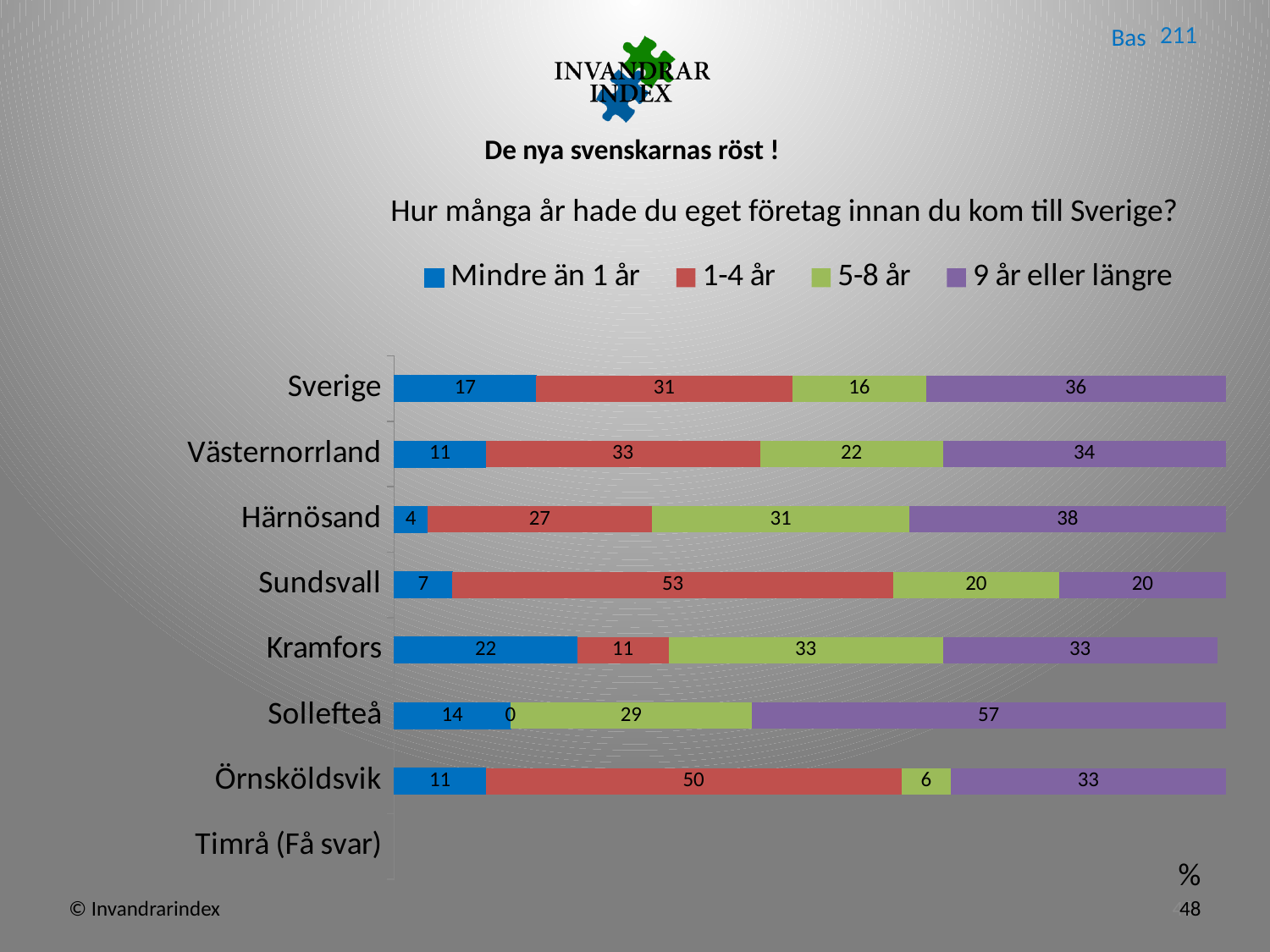
What is the value for '5-8 år' for Örnsköldsvik? 6 What is the value for '9 år eller längre' for Sollefteå? 57 Which category has the highest value for '9 år eller längre'? Sollefteå What kind of chart is shown on the slide? stacked bar chart What is the total of the stacked bar for Sverige? 100 Which category has the lowest value for 'Mindre än 1 år' among those with plotted data? Härnösand What is the difference between the '1-4 år' values for Sundsvall and Kramfors? 42 What is the value for 'Mindre än 1 år' for Härnösand? 4 What is the value for '1-4 år' for Sundsvall? 53 How many series does the legend list? 4 Which category on the chart has no bar plotted? Timrå (Få svar) Which is larger: the '5-8 år' value for Härnösand or for Västernorrland? Härnösand